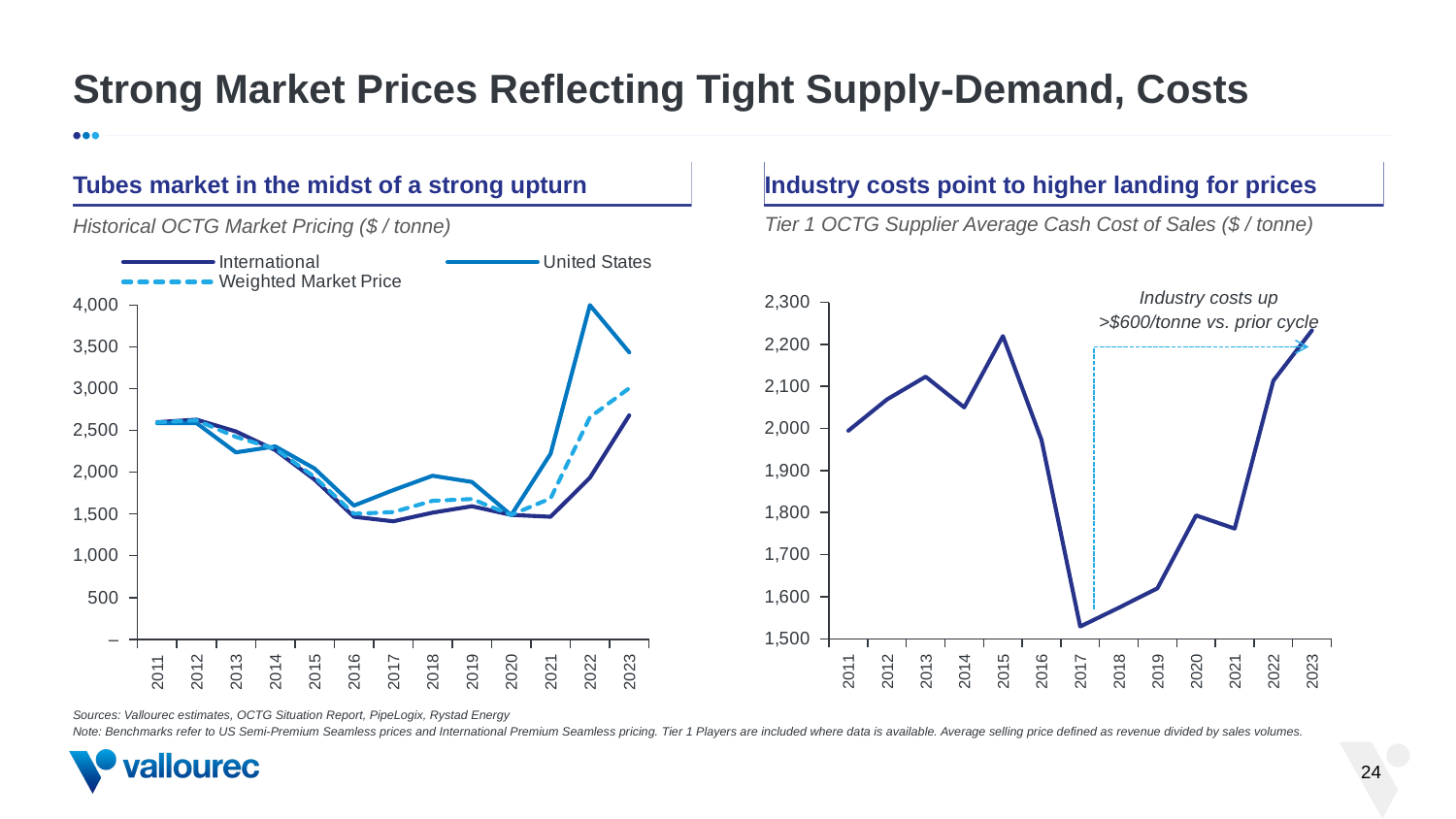
In the right chart, Tier 1 OCTG Supplier Average Cash Cost of Sales, which is larger, the value for 2015 or the value for 2017? 2015 In the right chart, Tier 1 OCTG Supplier Average Cash Cost of Sales, is the value for 2021 greater or less than 1,800? less In the right chart, Tier 1 OCTG Supplier Average Cash Cost of Sales, is the value for 2017 greater or less than 1,600? less In the left chart, Historical OCTG Market Pricing, which series reaches the highest value in 2022? United States What kind of chart is the left chart, Historical OCTG Market Pricing? Line chart In the right chart, Tier 1 OCTG Supplier Average Cash Cost of Sales, do values rise or fall from 2017 to 2023? rise What does the annotation on the right chart, Tier 1 OCTG Supplier Average Cash Cost of Sales, say? Industry costs up >$600/tonne vs. prior cycle In the right chart, Tier 1 OCTG Supplier Average Cash Cost of Sales, which year has the lowest value? 2017 How many series does the legend of the left chart, Historical OCTG Market Pricing, list? 3 In the left chart, Historical OCTG Market Pricing, is the United States value for 2022 greater or less than 3,500? greater How many years are shown on the x axis of the right chart, Tier 1 OCTG Supplier Average Cash Cost of Sales? 13